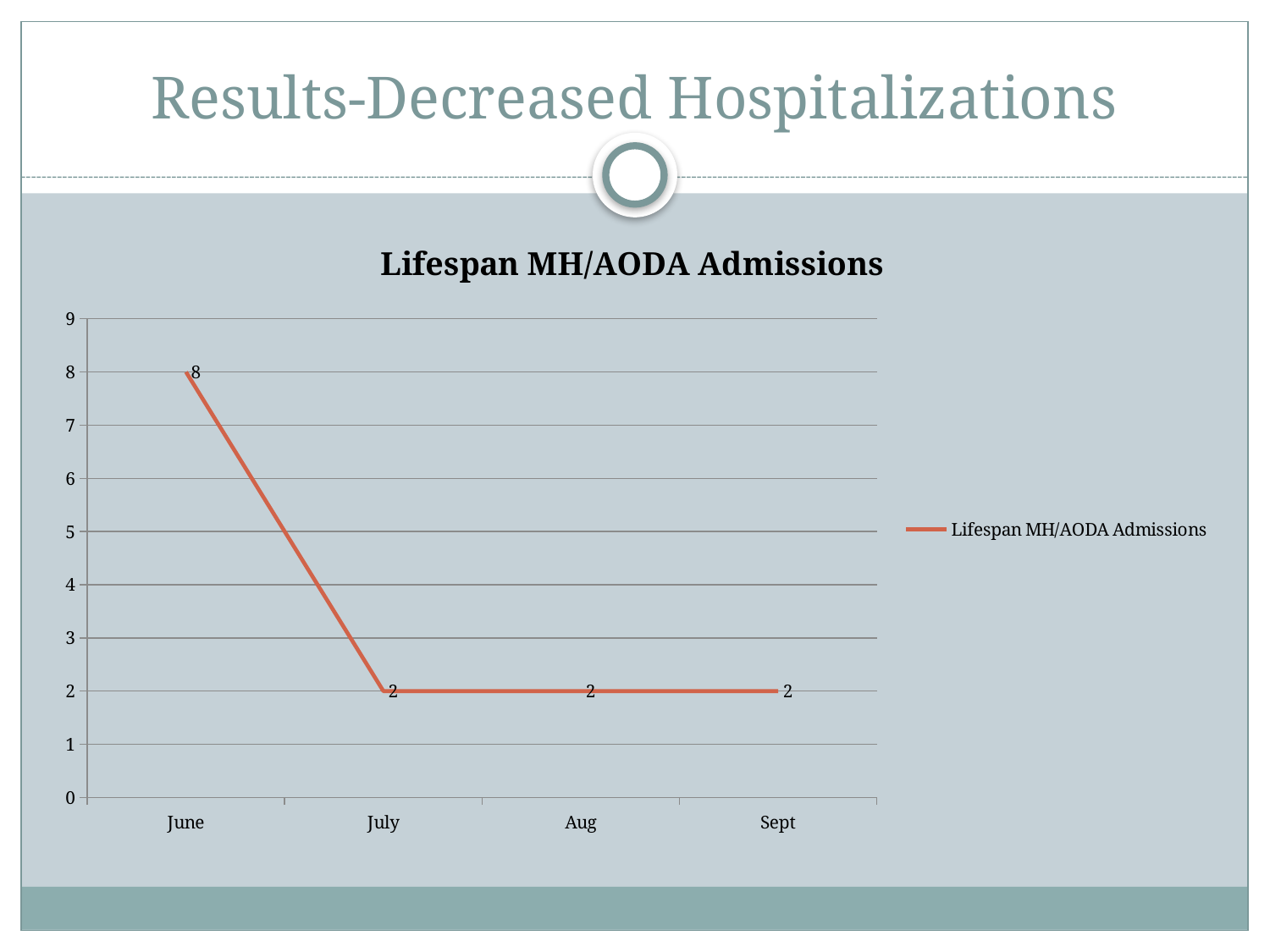
What is the title of the chart? Lifespan MH/AODA Admissions Is the value for June greater or less than 5? greater What is the value for June? 8 How many series does the legend list? 1 Which month has the highest number of admissions? June Which is larger, the value for June or the value for Aug? June What is the difference between the June value and the July value? 6 Do the values rise or fall from June to July? fall What kind of chart is shown? line chart What is the value for Sept? 2 What is the value for July? 2 How many months are plotted on the x axis? 4